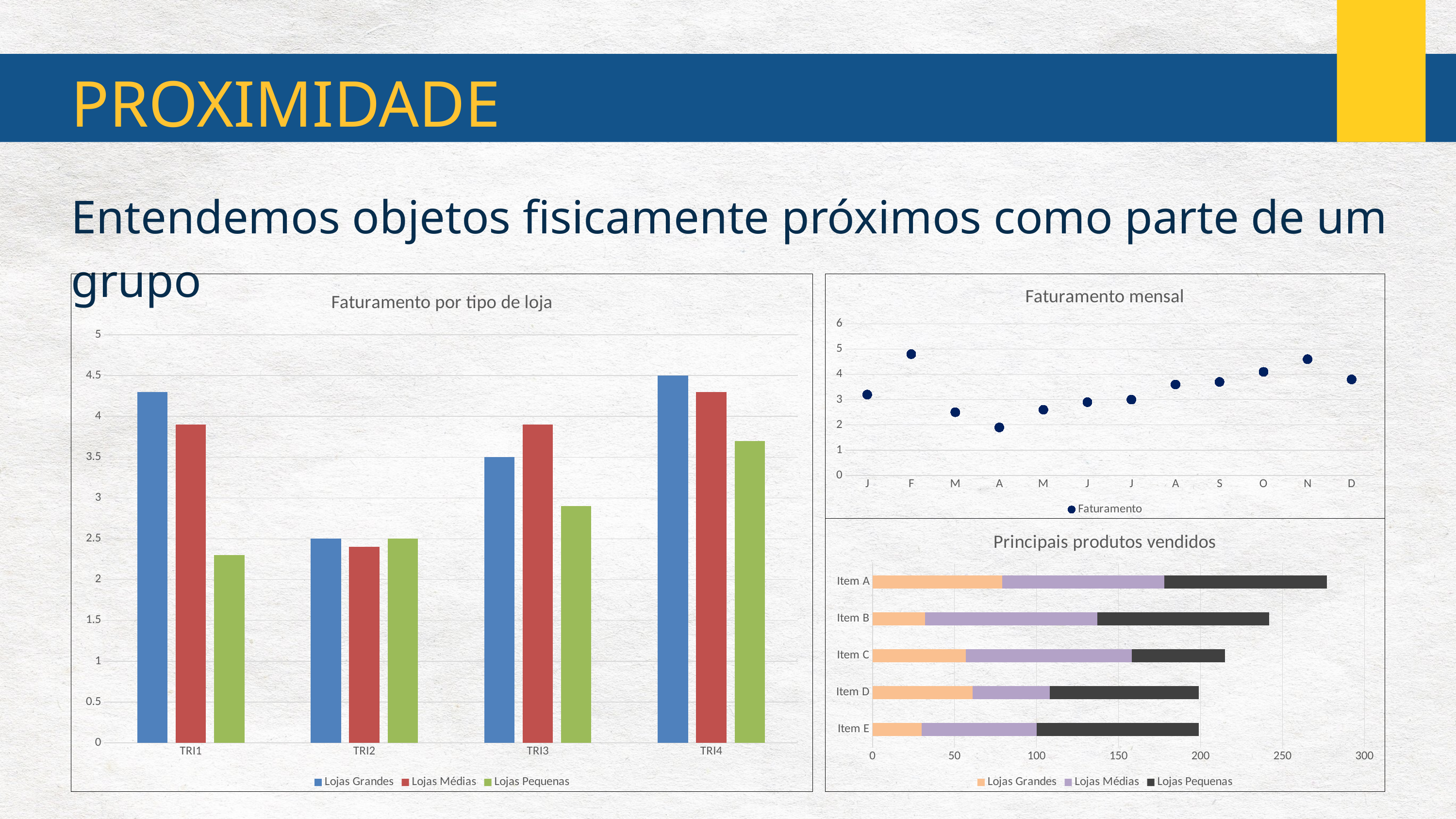
In the 'Faturamento por tipo de loja' chart, which quarter has the lowest value for Lojas Médias? TRI2 In the 'Faturamento por tipo de loja' chart, which series has the highest value in TRI4? Lojas Grandes In the 'Faturamento por tipo de loja' chart, which is larger: Lojas Grandes in TRI1 or Lojas Grandes in TRI3? Lojas Grandes in TRI1 In the 'Principais produtos vendidos' chart, is the total for Item A greater or less than 250? greater In the 'Faturamento por tipo de loja' chart, what kind of chart is it? bar chart In the 'Faturamento por tipo de loja' chart, how many categories are shown on the x axis? 4 In the 'Faturamento por tipo de loja' chart, is the value for Lojas Pequenas in TRI1 greater or less than 2.5? less In the 'Principais produtos vendidos' chart, which item has the longest total bar? Item A In the 'Faturamento mensal' chart, how many data points are plotted? 12 In the 'Faturamento mensal' chart, which month has the highest value? F In the 'Faturamento por tipo de loja' chart, how many series does the legend list? 3